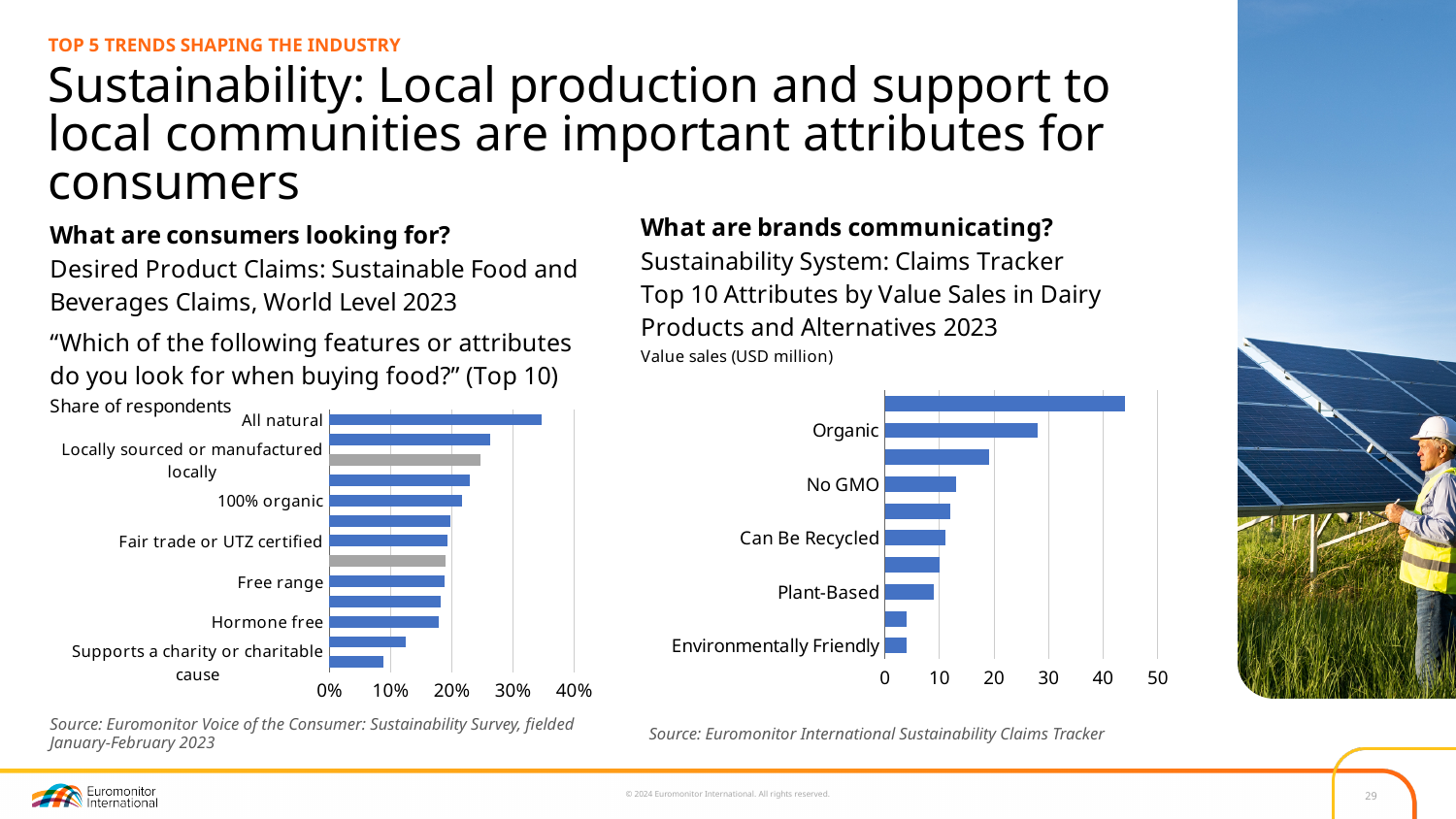
How many bars are plotted in the right chart on top 10 attributes by value sales in dairy products and alternatives? 10 In the left chart on desired product claims, which labelled attribute has the lowest share of respondents? Supports a charity or charitable cause In the left chart on desired product claims, which has a larger share of respondents: 'All natural' or 'Hormone free'? All natural What unit is used for value sales in the right chart on attributes by value sales in dairy products and alternatives? USD million In the left chart on desired product claims, is the share of respondents for 'All natural' greater or less than 30%? greater In the right chart on attributes by value sales in dairy, is the value for 'Organic' greater or less than 20? greater What kind of chart is the right chart, 'Sustainability System: Claims Tracker Top 10 Attributes by Value Sales in Dairy Products and Alternatives 2023'? Bar chart In the left chart on desired product claims, is the share of respondents for 'Hormone free' greater or less than 20%? less In the left chart on desired product claims, which attribute has the highest share of respondents? All natural In the right chart on attributes by value sales in dairy, which has a larger value: 'Organic' or 'No GMO'? Organic What kind of chart is the left chart, 'Desired Product Claims: Sustainable Food and Beverages Claims, World Level 2023'? Bar chart